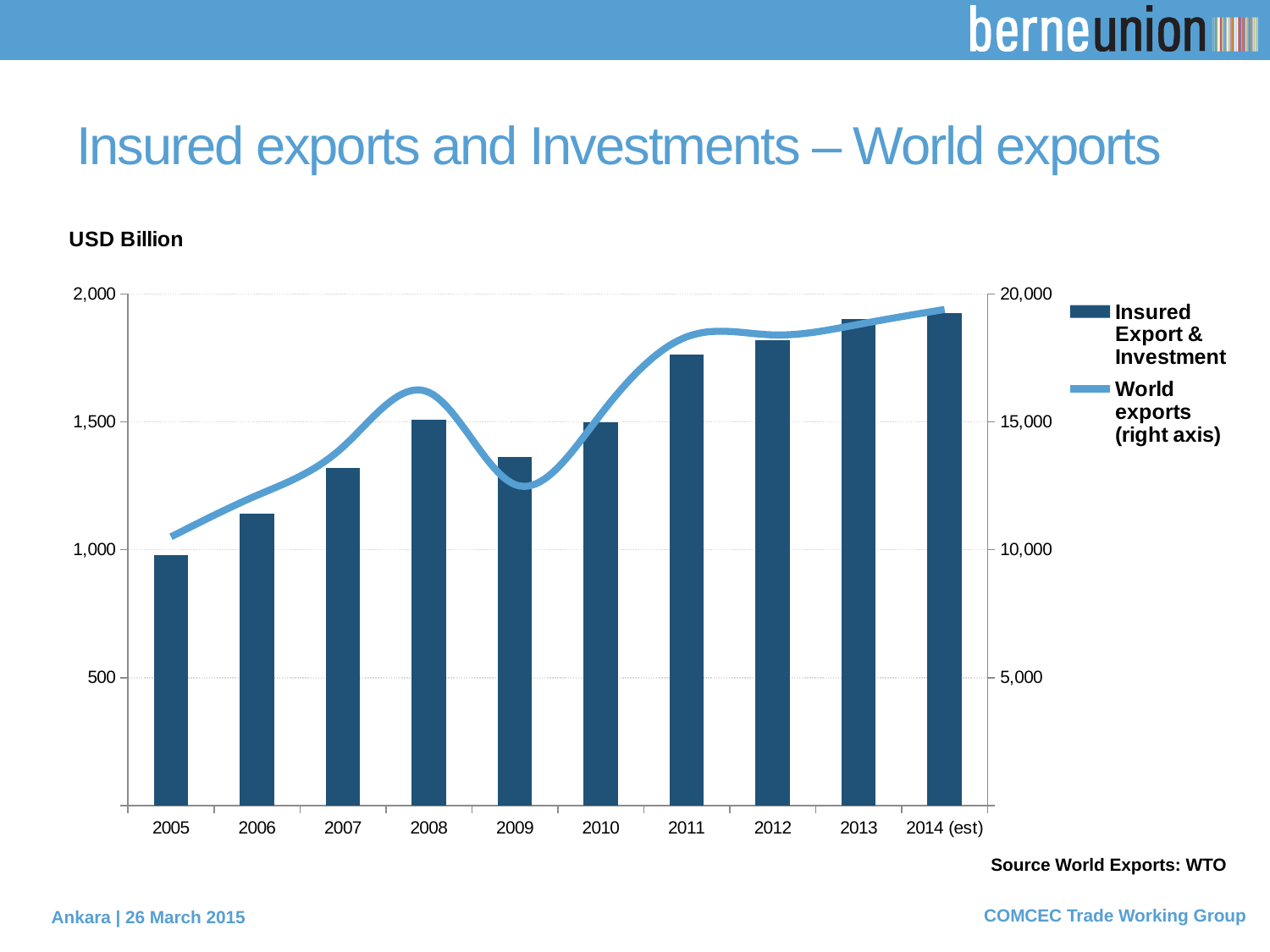
Which year has the lowest Insured Export & Investment bar? 2005 Is the World exports value for 2014 (est) greater or less than 15,000 on the right axis? greater How many years are shown on the x axis of the chart? 10 Is the Insured Export & Investment value for 2009 greater or less than 1,500? less Is the Insured Export & Investment value for 2011 greater or less than 1,500? greater How many series does the chart legend list? 2 Which year has the larger Insured Export & Investment bar, 2008 or 2009? 2008 What kind of chart is used to show Insured Export & Investment? bar chart According to the legend, which series is plotted on the right axis? World exports Overall, do the Insured Export & Investment bars rise or fall from 2005 to 2014 (est)? rise